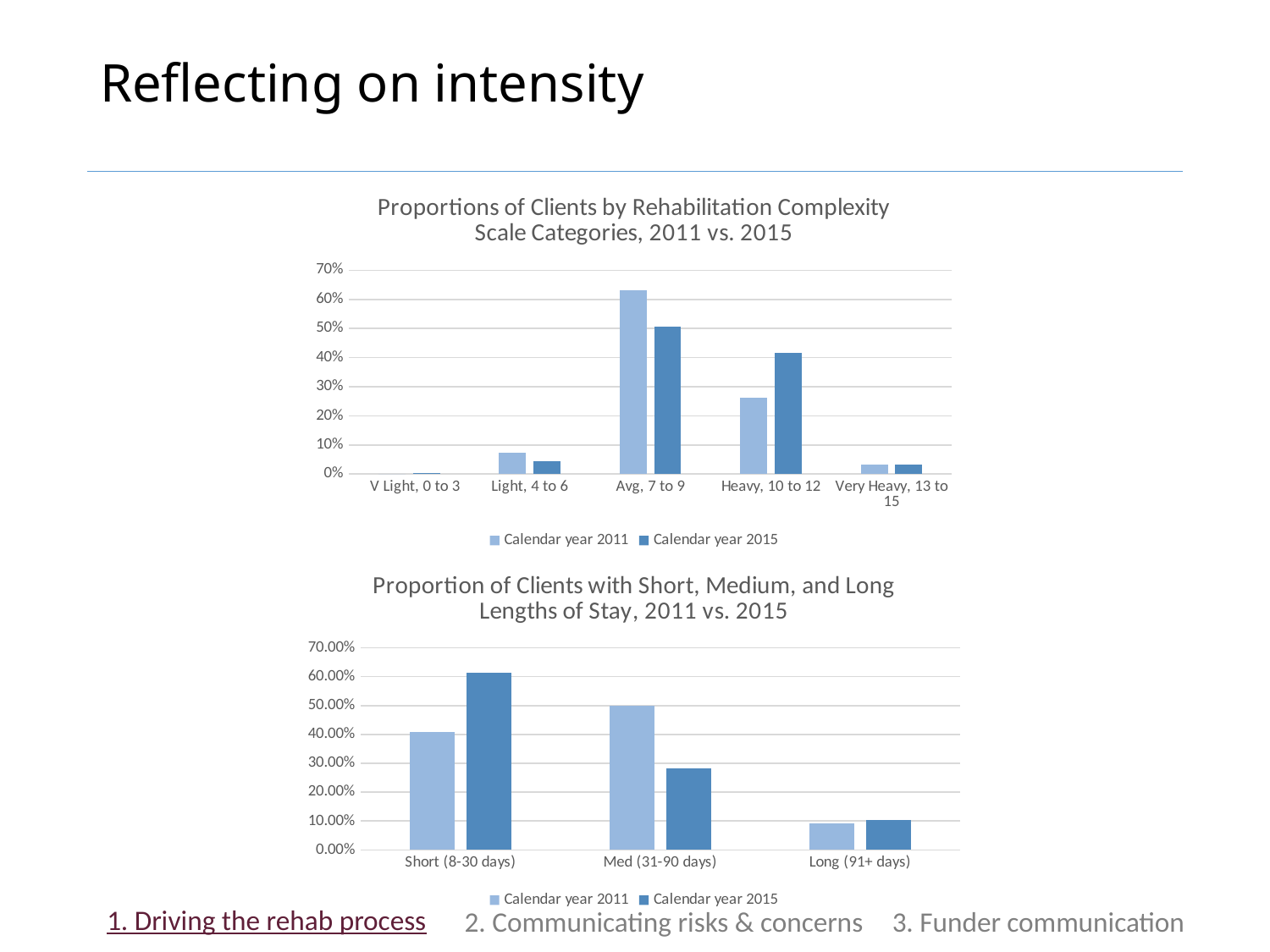
In the bottom chart, 'Proportion of Clients with Short, Medium, and Long Lengths of Stay, 2011 vs. 2015', what kind of chart is shown? bar chart In the top chart, 'Proportions of Clients by Rehabilitation Complexity Scale Categories, 2011 vs. 2015', how many series does the legend list? 2 In the top chart, 'Proportions of Clients by Rehabilitation Complexity Scale Categories, 2011 vs. 2015', is the Calendar year 2015 value for 'Heavy, 10 to 12' greater or less than 30%? greater In the bottom chart, 'Proportion of Clients with Short, Medium, and Long Lengths of Stay, 2011 vs. 2015', for 'Med (31-90 days)', which series has the larger value, Calendar year 2011 or Calendar year 2015? Calendar year 2011 In the bottom chart, 'Proportion of Clients with Short, Medium, and Long Lengths of Stay, 2011 vs. 2015', which category has the highest value for Calendar year 2015? Short (8-30 days) In the bottom chart, 'Proportion of Clients with Short, Medium, and Long Lengths of Stay, 2011 vs. 2015', is the Calendar year 2015 value for 'Short (8-30 days)' greater or less than 50.00%? greater In the top chart, 'Proportions of Clients by Rehabilitation Complexity Scale Categories, 2011 vs. 2015', which category has the highest value for Calendar year 2011? Avg, 7 to 9 In the top chart, 'Proportions of Clients by Rehabilitation Complexity Scale Categories, 2011 vs. 2015', for 'Heavy, 10 to 12', which series has the larger value, Calendar year 2011 or Calendar year 2015? Calendar year 2015 In the top chart, 'Proportions of Clients by Rehabilitation Complexity Scale Categories, 2011 vs. 2015', what kind of chart is shown? bar chart In the top chart, 'Proportions of Clients by Rehabilitation Complexity Scale Categories, 2011 vs. 2015', how many categories are shown on the x axis? 5 In the bottom chart, 'Proportion of Clients with Short, Medium, and Long Lengths of Stay, 2011 vs. 2015', how many categories are shown on the x axis? 3 In the top chart, 'Proportions of Clients by Rehabilitation Complexity Scale Categories, 2011 vs. 2015', is the Calendar year 2011 value for 'Avg, 7 to 9' greater or less than 50%? greater